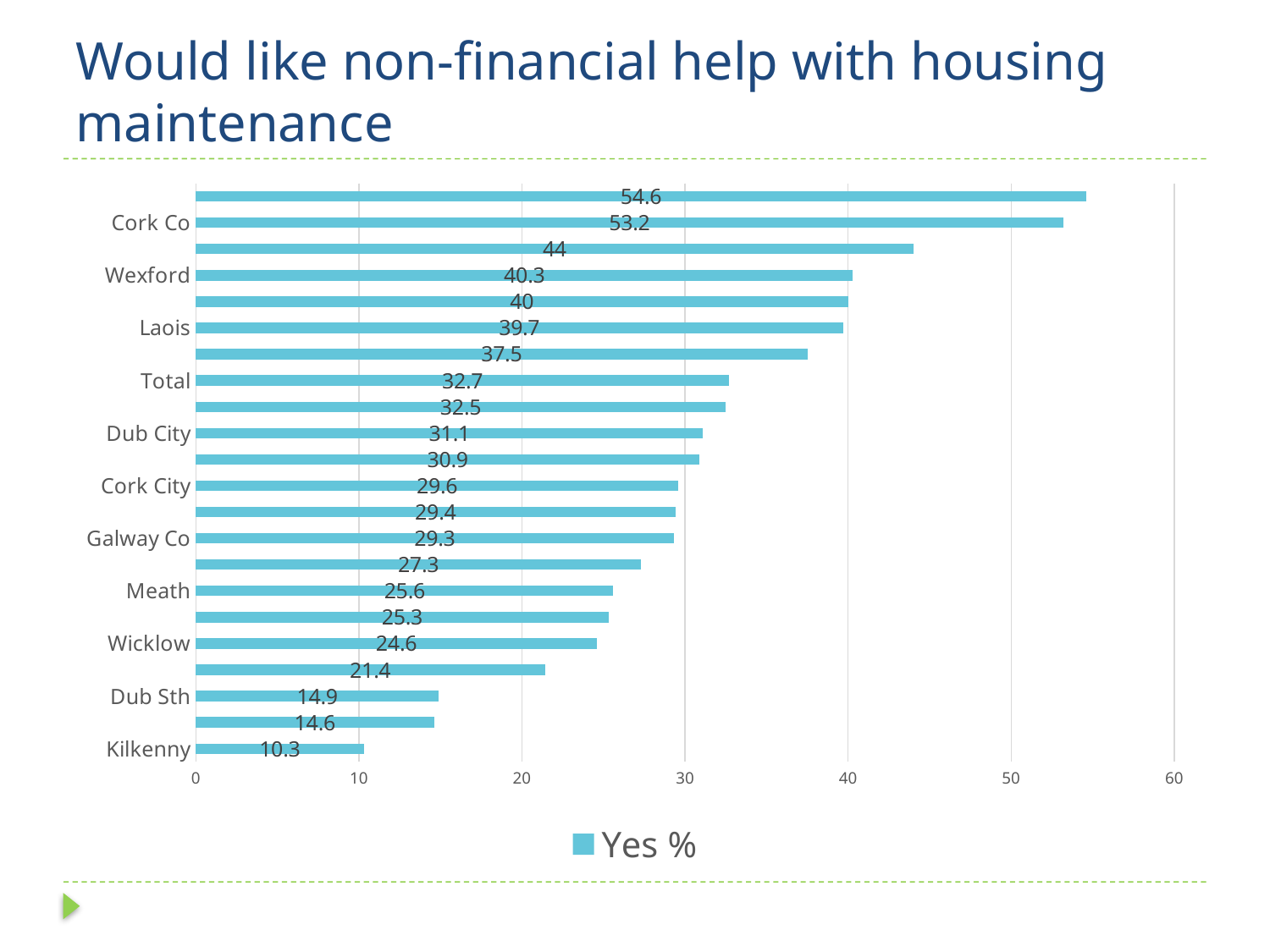
What is the difference between the values for Cork Co and Wexford? 12.9 How many bars are plotted in the chart? 22 What series name does the legend show? Yes % What is the value for Total? 32.7 What is the value for Kilkenny? 10.3 Is the value for Galway Co greater or less than 30? less What is the value for Dub Sth? 14.9 What is the value for Cork Co? 53.2 What kind of chart is shown on the slide? Bar chart What is the value for Wexford? 40.3 Which is larger, the value for Laois or the value for Meath? Laois Which labelled category has the lowest value? Kilkenny